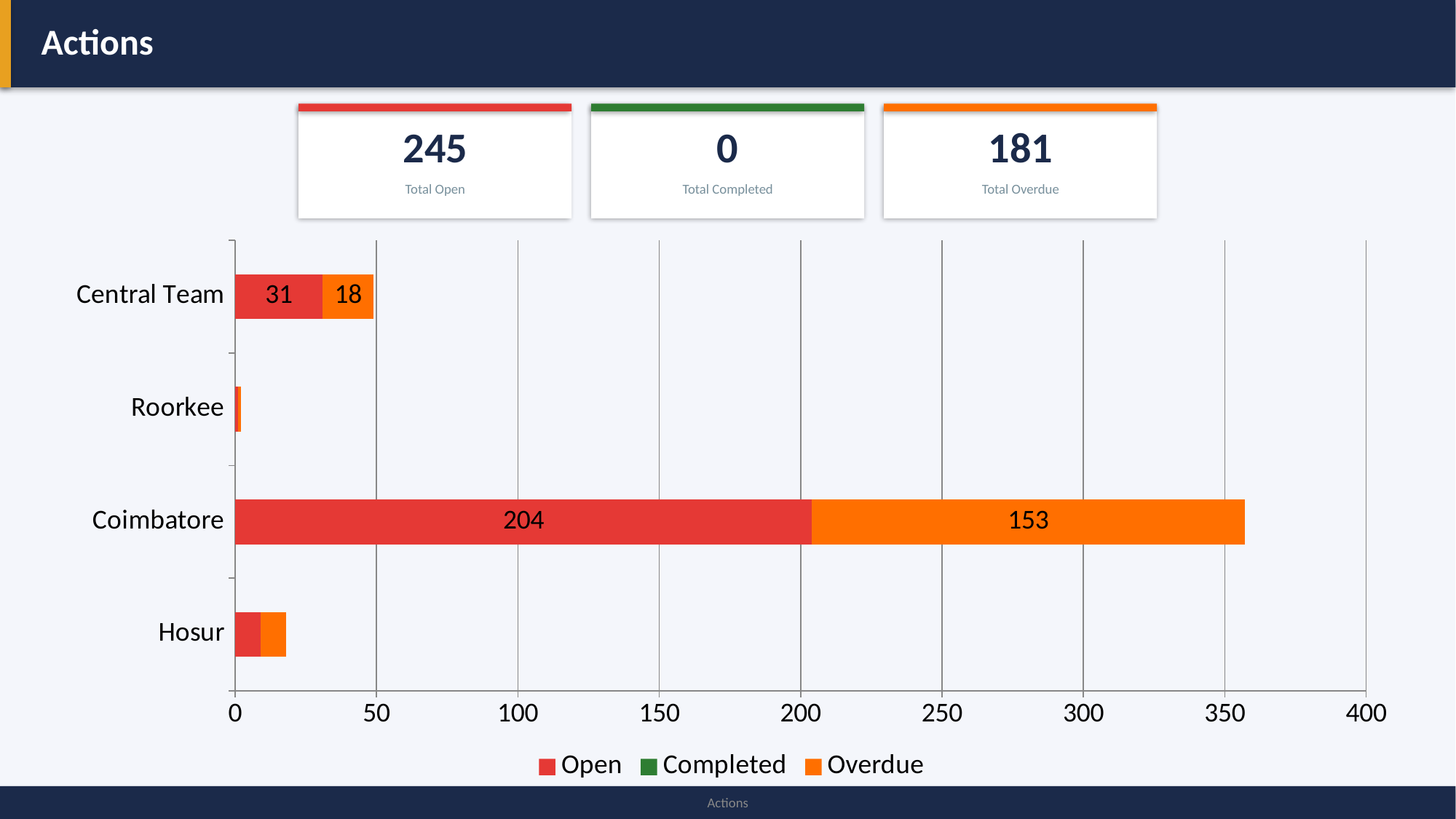
What is the Overdue value for Central Team? 18 What is the total of the stacked bar for Central Team? 49 Which category has the shortest stacked bar? Roorkee What is the total of the stacked bar for Coimbatore? 357 What is the Open value for Central Team? 31 What is the Overdue value for Coimbatore? 153 What is the difference between the Open and Overdue values for Coimbatore? 51 For Central Team, which is larger: the Open value or the Overdue value? Open Is the total stacked bar value for Hosur greater or less than 50? less How many series does the legend list? 3 What is the Open value for Coimbatore? 204 Which category has the longest stacked bar? Coimbatore